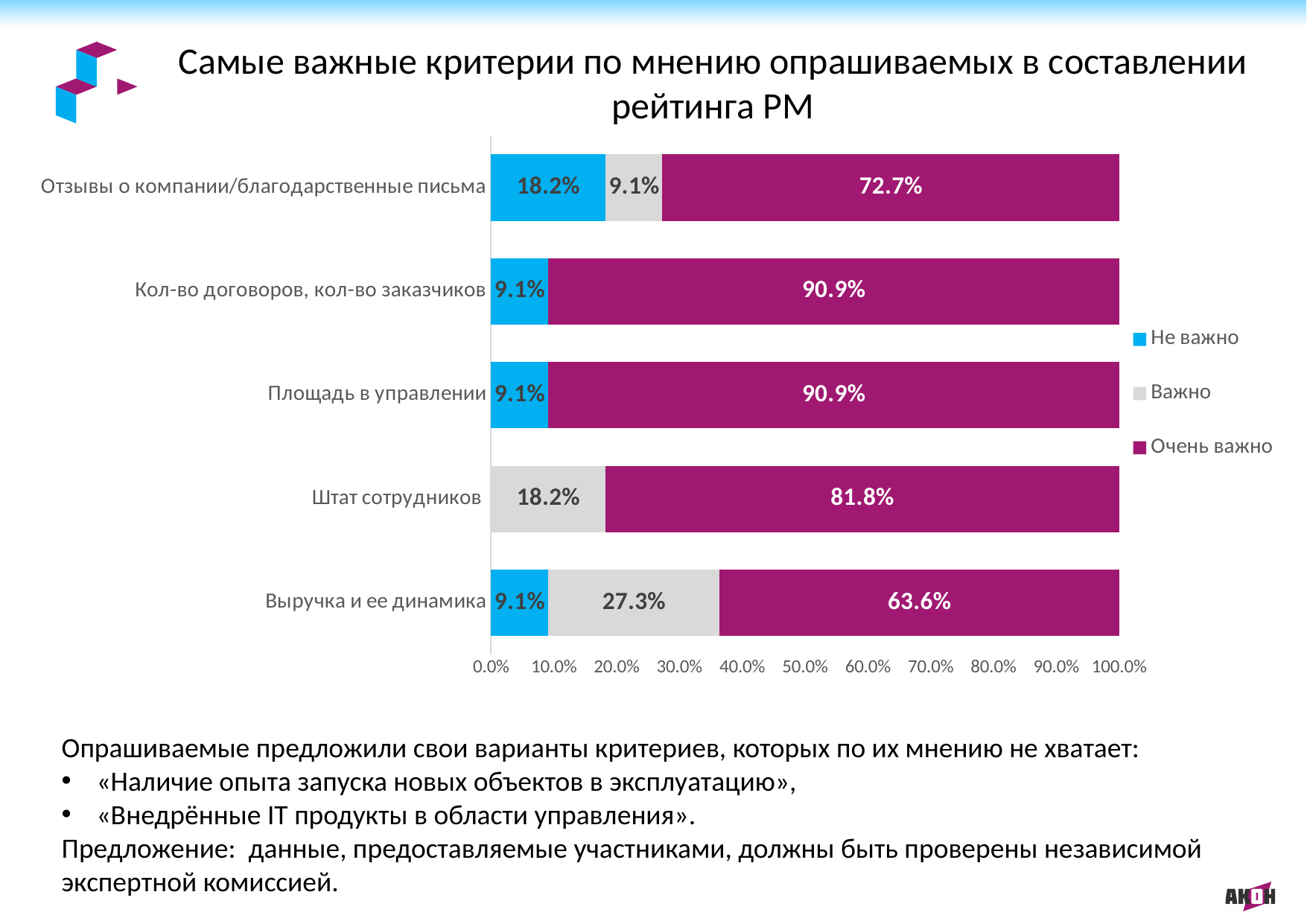
What is the "Важно" value for "Выручка и ее динамика"? 27.3% What is the difference between the "Очень важно" values for "Штат сотрудников" and "Выручка и ее динамика"? 18.2% Which is larger: the "Очень важно" value for "Отзывы о компании/благодарственные письма" or for "Штат сотрудников"? Штат сотрудников Which category has the lowest "Очень важно" share? Выручка и ее динамика How many categories are shown on the chart? 5 Which category has the highest "Важно" share? Выручка и ее динамика What share of respondents rated "Отзывы о компании/благодарственные письма" as "Очень важно"? 72.7% What is the "Важно" value for "Штат сотрудников"? 18.2% What type of chart is shown on the slide? Stacked bar chart What is the "Не важно" value for "Отзывы о компании/благодарственные письма"? 18.2% How many series does the legend list? 3 Which legend entry is shown in magenta? Очень важно